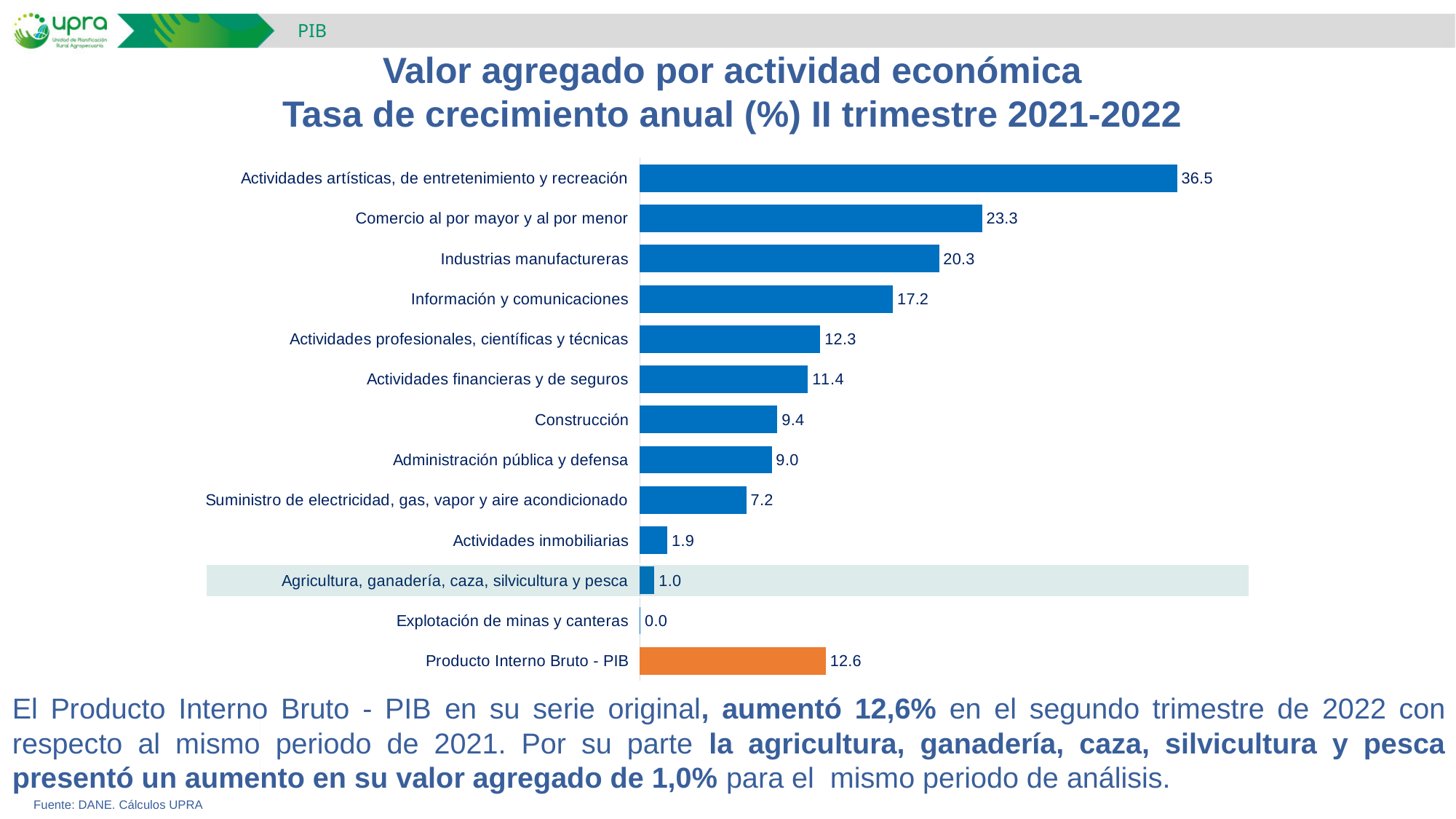
Which bar in the chart is coloured orange instead of blue? Producto Interno Bruto - PIB What is the difference between the value for Actividades artísticas, de entretenimiento y recreación and the value for Producto Interno Bruto - PIB? 23.9 What value is shown for Agricultura, ganadería, caza, silvicultura y pesca? 1.0 What type of chart is shown on the slide? Bar chart What is the difference between the values for Industrias manufactureras and Información y comunicaciones? 3.1 Which is larger, the value for Construcción or the value for Administración pública y defensa? Construcción How many categories (bars) are shown in the chart, including PIB? 13 What is the value of the bar for Producto Interno Bruto - PIB? 12.6 What is the annual growth rate shown for Comercio al por mayor y al por menor? 23.3 Which economic activity has the highest growth rate in the chart? Actividades artísticas, de entretenimiento y recreación What is the value shown for Suministro de electricidad, gas, vapor y aire acondicionado? 7.2 Which economic activity has the lowest growth rate in the chart? Explotación de minas y canteras